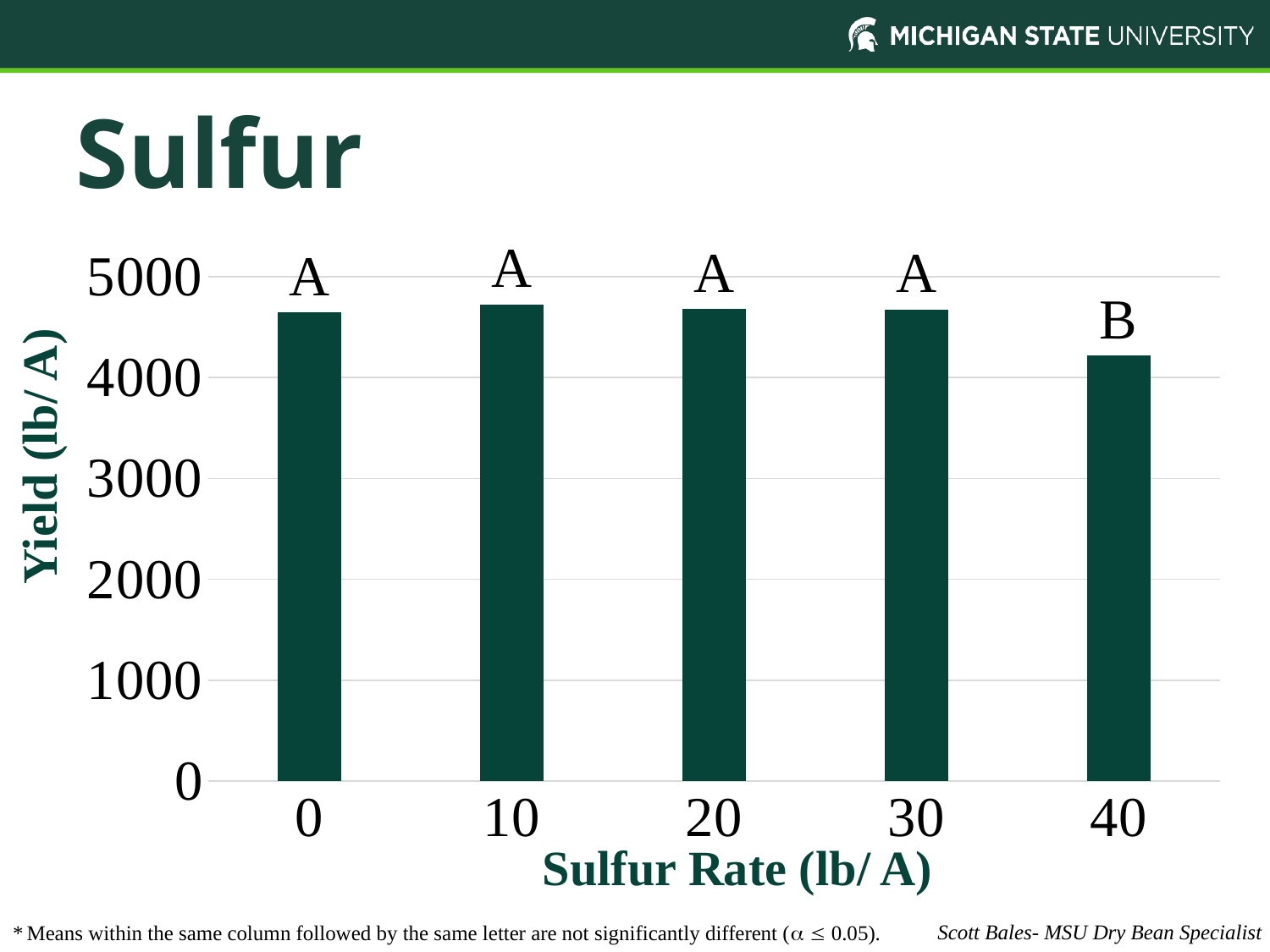
Is the yield for a sulfur rate of 40 greater or less than 4500? less Which sulfur rate has the lowest yield? 40 What significance letter is printed above the bar for a sulfur rate of 40? B Which has the higher yield: a sulfur rate of 20 or a sulfur rate of 40? 20 Which has the higher yield: a sulfur rate of 40 or a sulfur rate of 0? 0 What is the label of the y axis? Yield (lb/ A) Is the yield for a sulfur rate of 10 greater or less than 5000? less What kind of chart is shown on the slide? bar chart Is the yield for a sulfur rate of 0 greater or less than 4000? greater How many sulfur rate categories are plotted on the x axis? 5